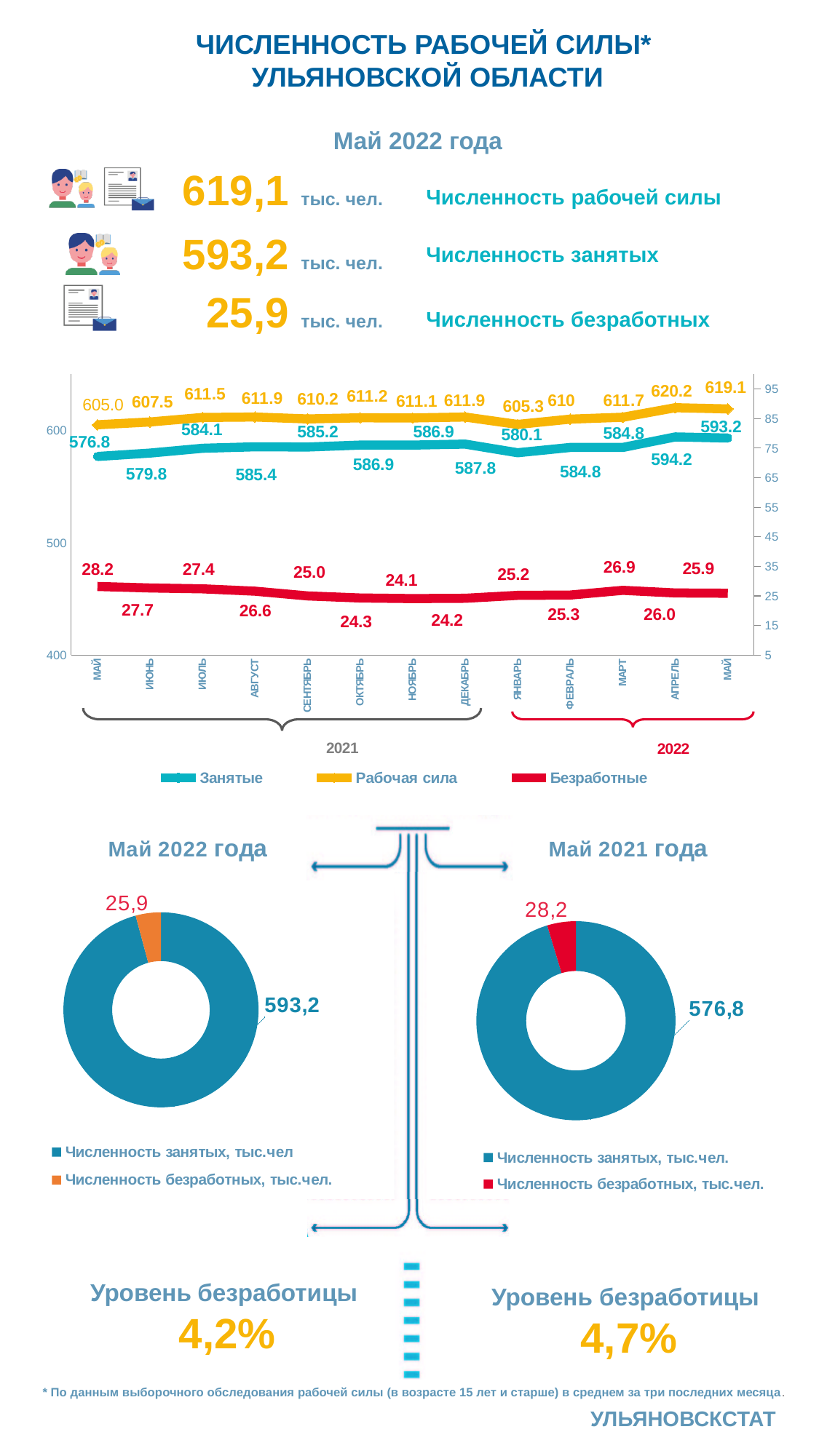
On the line chart, what is the value of Безработные in November 2021 (НОЯБРЬ)? 24.1 How many months are plotted on the line chart? 13 How many series does the legend of the line chart list? 3 On the line chart, which is larger: Безработные in March 2022 or in April 2022? March 2022 What kind of chart is the chart showing Занятые, Рабочая сила and Безработные by month? Line chart On the line chart, in which month does Рабочая сила reach its highest value? Апрель 2022 On the line chart, by how much did Занятые increase from May 2021 to May 2022? 16.4 On the line chart, in which month is the Безработные series at its lowest? Ноябрь 2021 On the line chart, what is the value of Рабочая сила in April 2022 (АПРЕЛЬ)? 620.2 On the line chart, by how much did Безработные decrease from May 2021 to May 2022? 2.3 On the Май 2021 года doughnut chart, what is the value for Численность занятых? 576,8 On the line chart, does the Безработные series rise or fall from May 2021 to November 2021? Fall